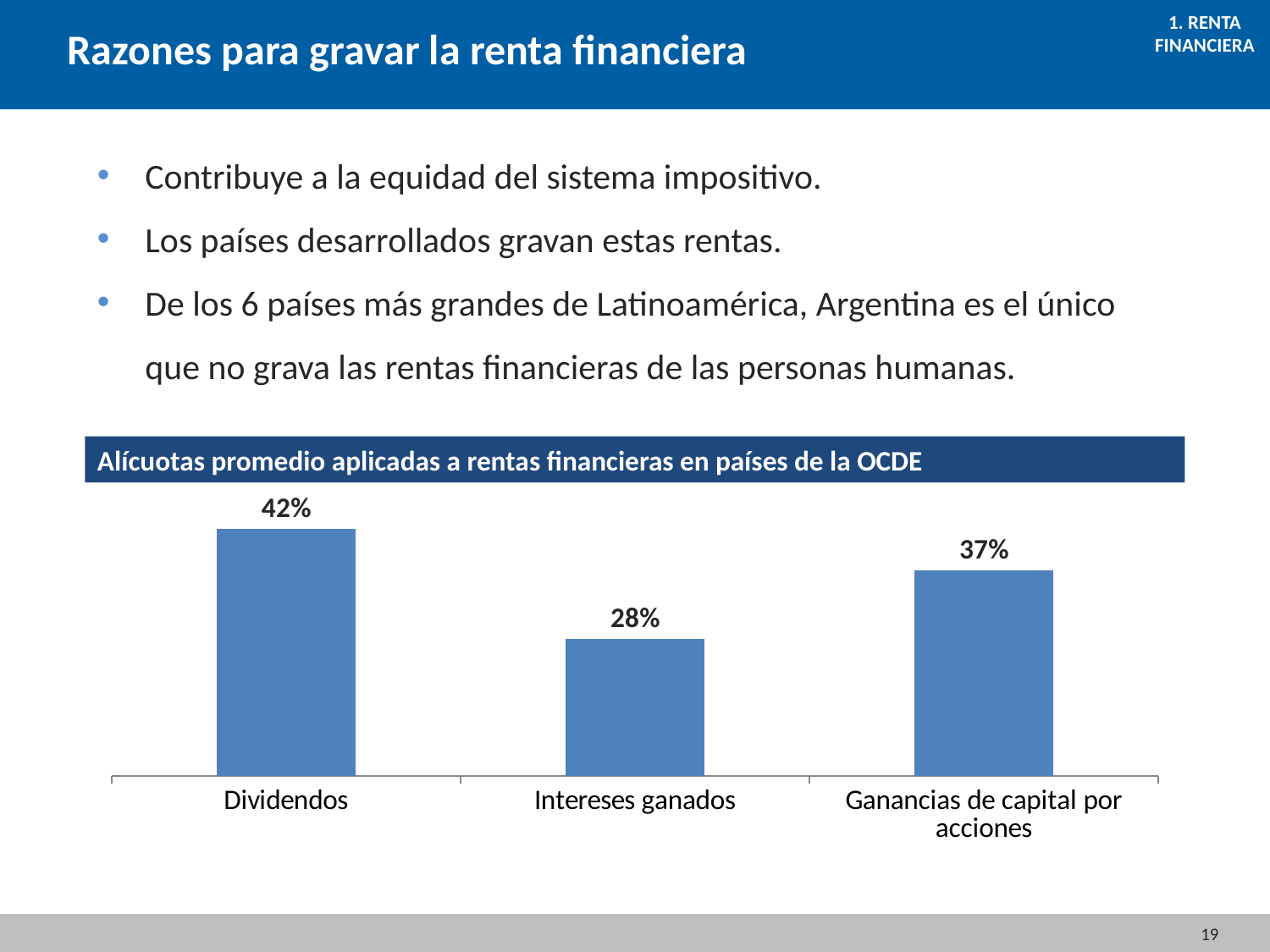
What colour are the bars in the chart? Blue Which is larger, the value for Intereses ganados or the value for Ganancias de capital por acciones? Ganancias de capital por acciones Which category has the lowest value? Intereses ganados What is the title of the chart? Alícuotas promedio aplicadas a rentas financieras en países de la OCDE Which category has the highest value? Dividendos How many categories are shown in the chart? 3 What is the value for Ganancias de capital por acciones? 37% What kind of chart is shown on the slide? Bar chart What is the value for Intereses ganados? 28% What is the difference between the values for Dividendos and Intereses ganados? 14% What is the difference between the values for Dividendos and Ganancias de capital por acciones? 5% What is the value for Dividendos? 42%